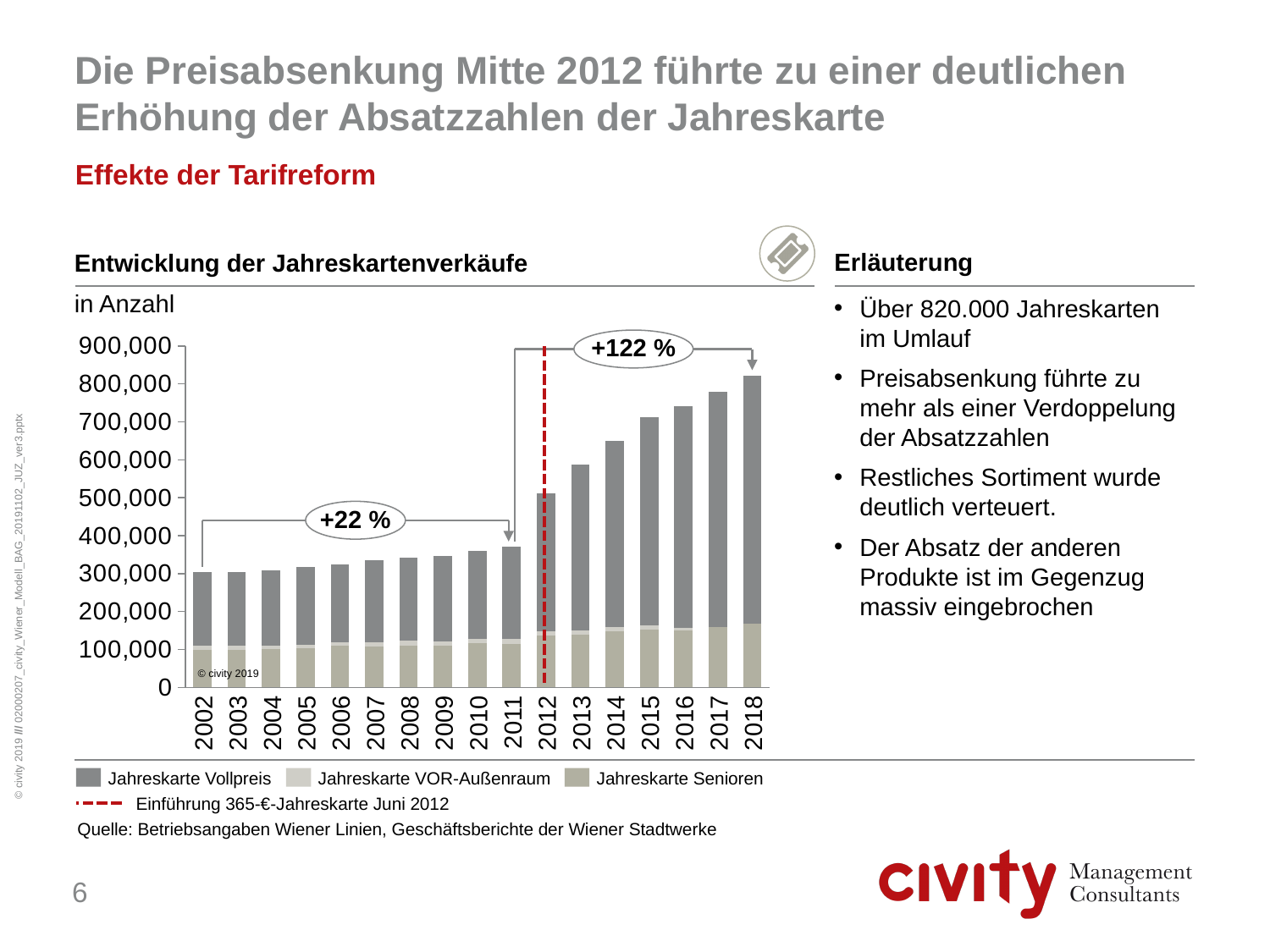
What percentage increase is annotated between 2011 and 2018? +122 % How many stacked series (ticket types) does the legend list for the bars? 3 How many years are shown on the x axis of the chart? 17 What percentage increase is annotated between 2002 and 2011? +22 % Is the total value for 2013 greater or less than 500,000? greater Which year has the highest total bar in the chart? 2018 Is the total value for 2018 greater or less than 700,000? greater What kind of chart is shown under 'Entwicklung der Jahreskartenverkäufe'? Stacked bar chart Is the total value for 2002 greater or less than 400,000? less What does the red dashed vertical line in the chart mark, according to the legend? Einführung 365-€-Jahreskarte Juni 2012 Do the total annual ticket sales rise or fall from 2002 to 2018? Rise Which year has the larger total bar, 2011 or 2012? 2012